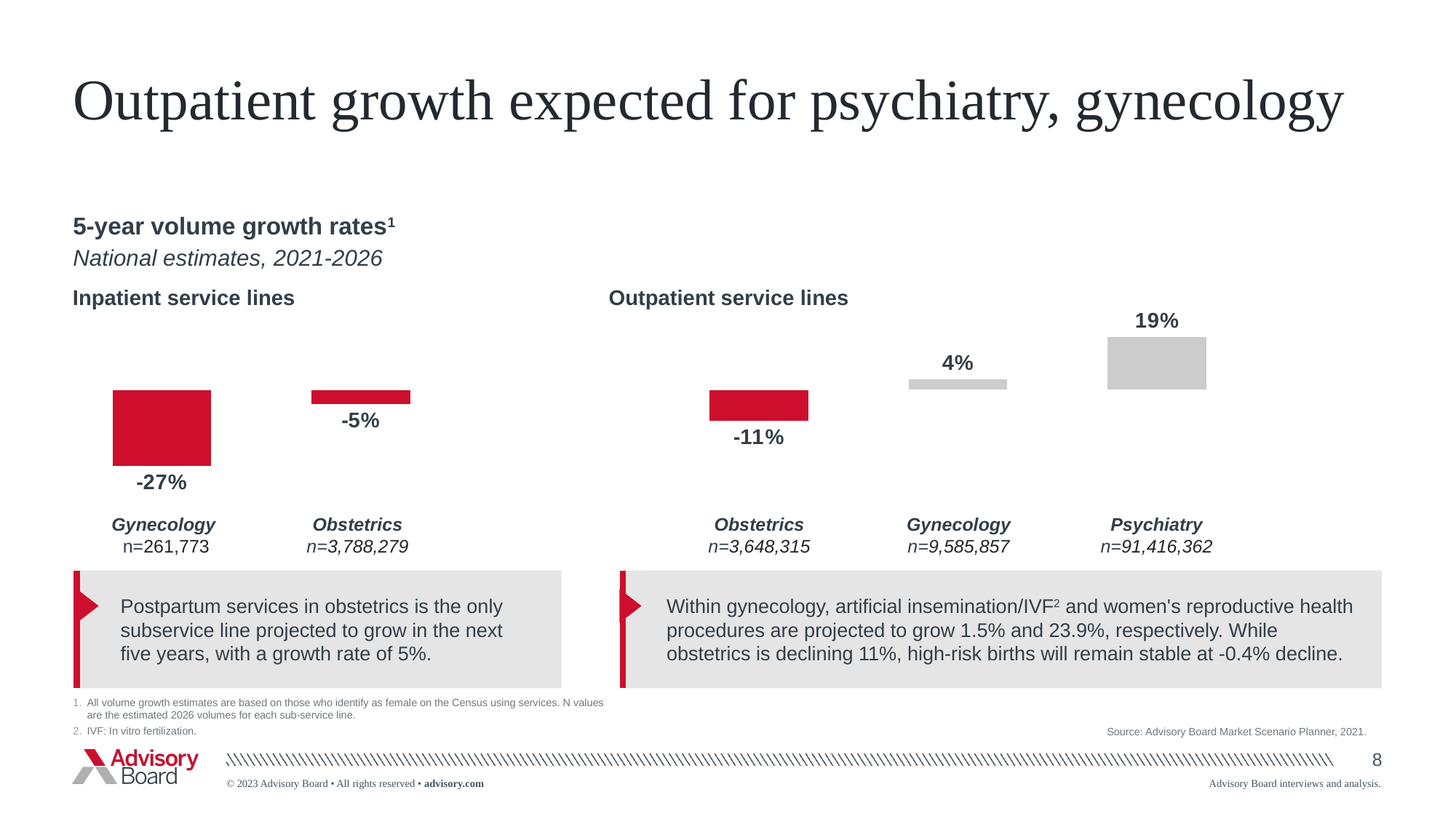
In the Outpatient service lines chart, what is the n value shown for Psychiatry? n=91,416,362 In the Inpatient service lines chart, which service line has the lowest growth rate? Gynecology In the Outpatient service lines chart, what is the growth rate for Psychiatry? 19% In the Outpatient service lines chart, what is the growth rate for Gynecology? 4% Which has a higher growth rate: Obstetrics in the Inpatient chart or Obstetrics in the Outpatient chart? Inpatient Obstetrics In the Outpatient service lines chart, which service line has the highest growth rate? Psychiatry In the Inpatient service lines chart, what is the 5-year volume growth rate for Gynecology? -27% What type of chart is used for the Inpatient service lines? Bar chart In the Inpatient service lines chart, what is the growth rate for Obstetrics? -5% How many service lines are shown in the Outpatient service lines chart? 3 In the Outpatient service lines chart, what is the growth rate for Obstetrics? -11% In the Outpatient service lines chart, what is the difference between the Psychiatry and Gynecology growth rates? 15 percentage points